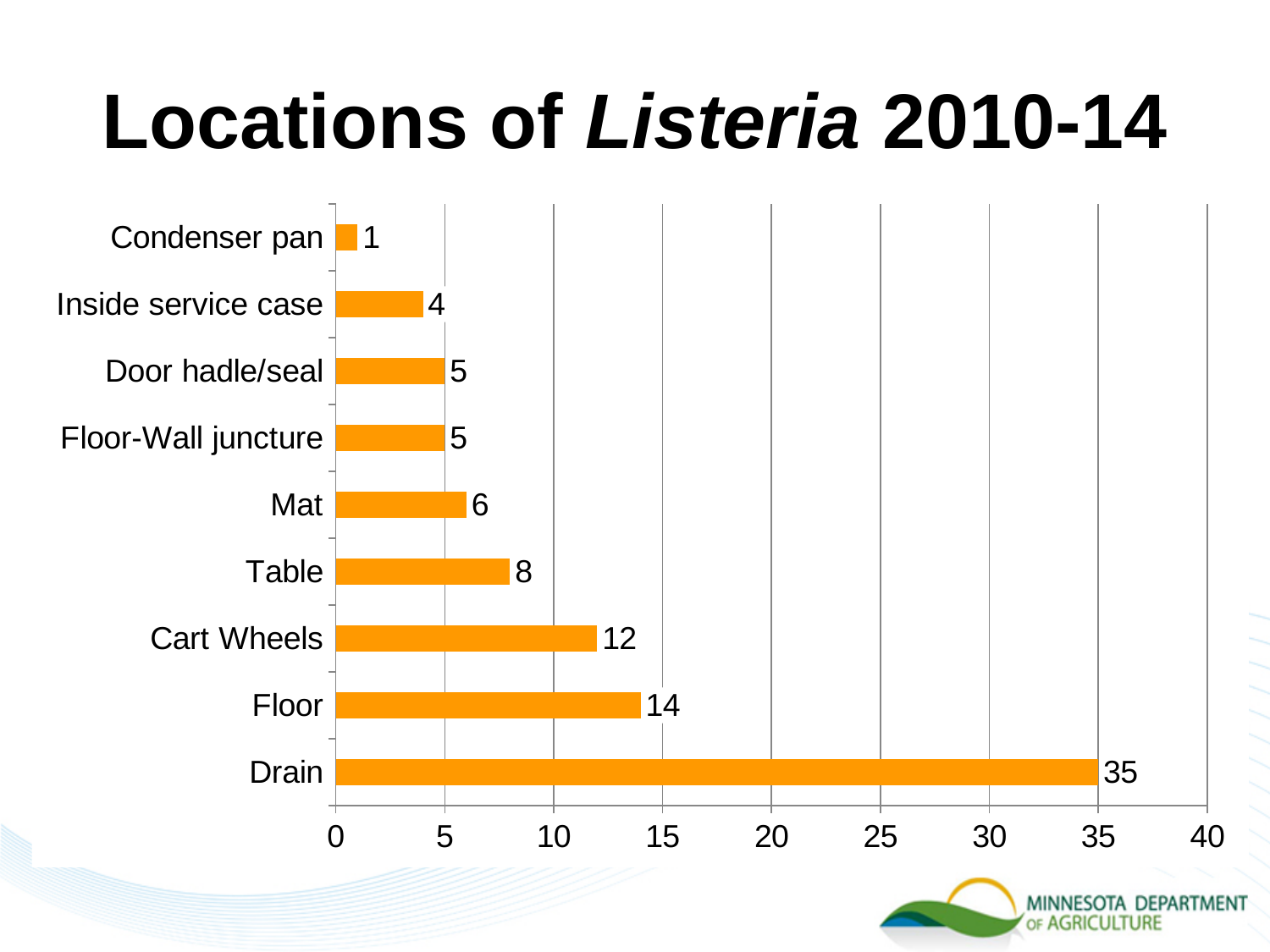
How many locations are shown in the chart? 9 Which location has the lowest value? Condenser pan What kind of chart is shown on the slide? bar chart What is the difference between the values for Table and Mat? 2 What is the value for Cart Wheels? 12 Which location has the highest value? Drain What is the value for Drain? 35 Is the value for Drain greater or less than 30? greater What is the value for Inside service case? 4 What is the difference between the values for Drain and Floor? 21 What is the title of the chart? Locations of Listeria 2010-14 Which is larger, the value for Floor or the value for Cart Wheels? Floor